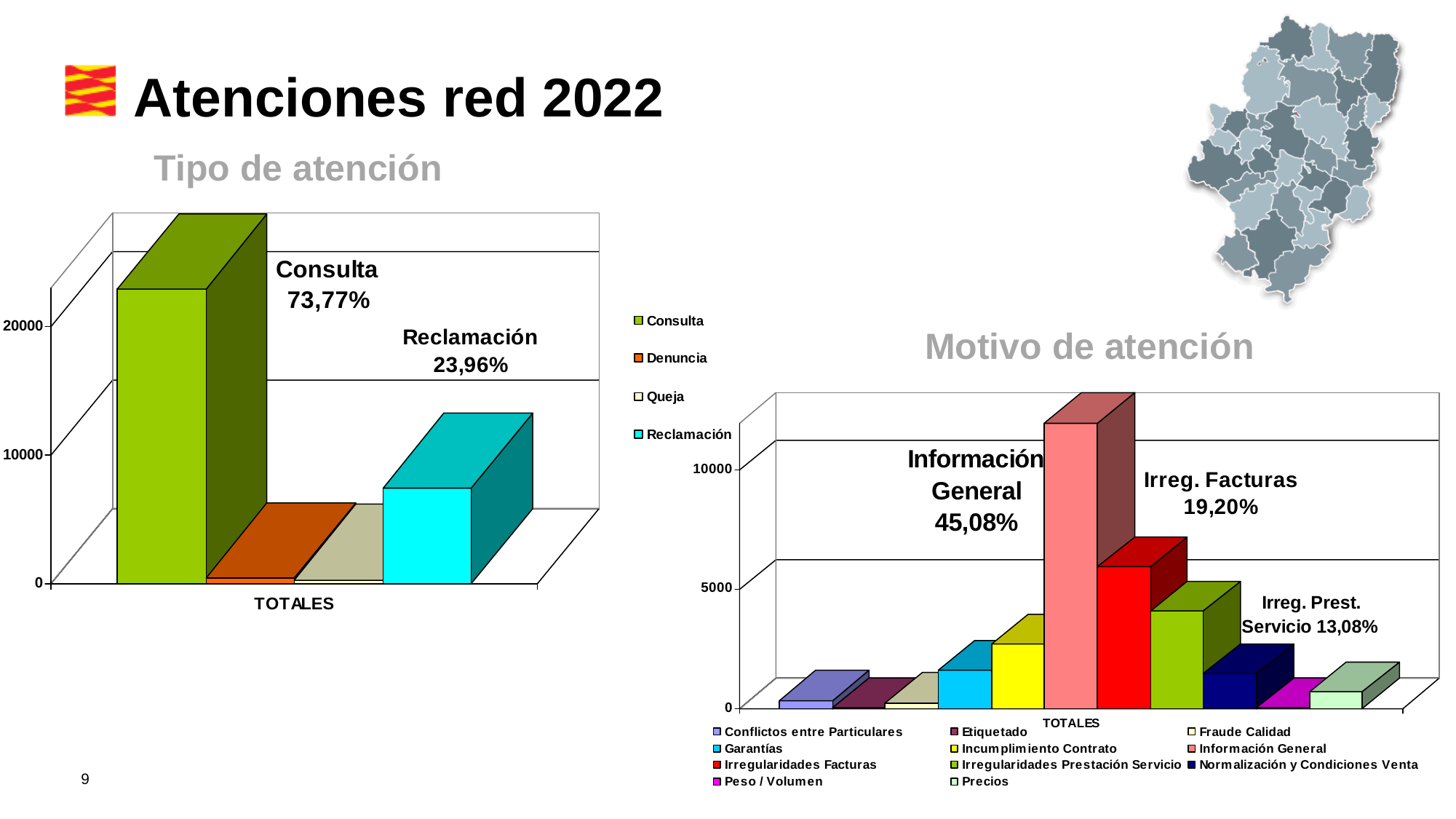
In the 'Tipo de atención' chart, what percentage is shown for Consulta? 73,77% In the 'Motivo de atención' chart, which series has the highest value? Información General In the 'Motivo de atención' chart, what percentage is shown for Irreg. Prest. Servicio? 13,08% What kind of chart is the 'Tipo de atención' chart? bar chart In the 'Tipo de atención' chart, what percentage is shown for Reclamación? 23,96% In the 'Motivo de atención' chart, what percentage is shown for Información General? 45,08% How many series does the legend of the 'Tipo de atención' chart list? 4 In the 'Tipo de atención' chart, is the value for Reclamación greater or less than 10000? less In the 'Tipo de atención' chart, which series has the highest value? Consulta In the 'Motivo de atención' chart, what is the difference in percentage points between Información General and Irreg. Facturas? 25,88% How many series does the legend of the 'Motivo de atención' chart list? 11 In the 'Tipo de atención' chart, is the value for Consulta greater or less than 20000? greater